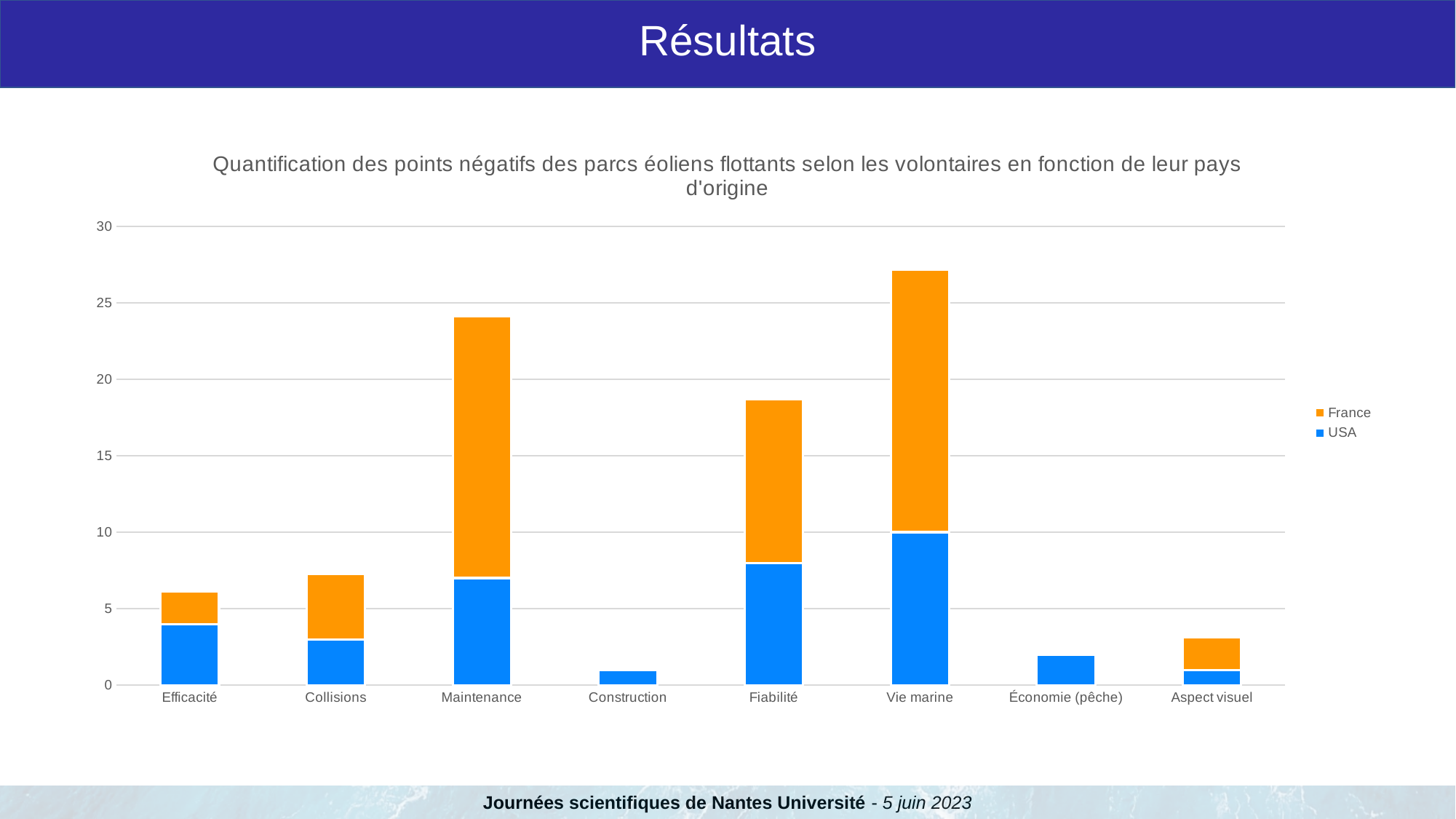
How many categories are shown on the x axis? 8 What kind of chart is shown on the slide? Stacked bar chart Which has the larger total stacked value, Maintenance or Fiabilité? Maintenance Which category has no visible France (orange) segment besides Construction? Économie (pêche) Is the total stacked value for Aspect visuel greater or less than 5? less How many series does the legend list? 2 Which category has the tallest stacked bar overall? Vie marine Is the total stacked value for Maintenance greater or less than 20? greater Which series is shown in orange in the legend? France Is the total stacked value for Fiabilité greater or less than 20? less Which category has the shortest stacked bar overall? Construction